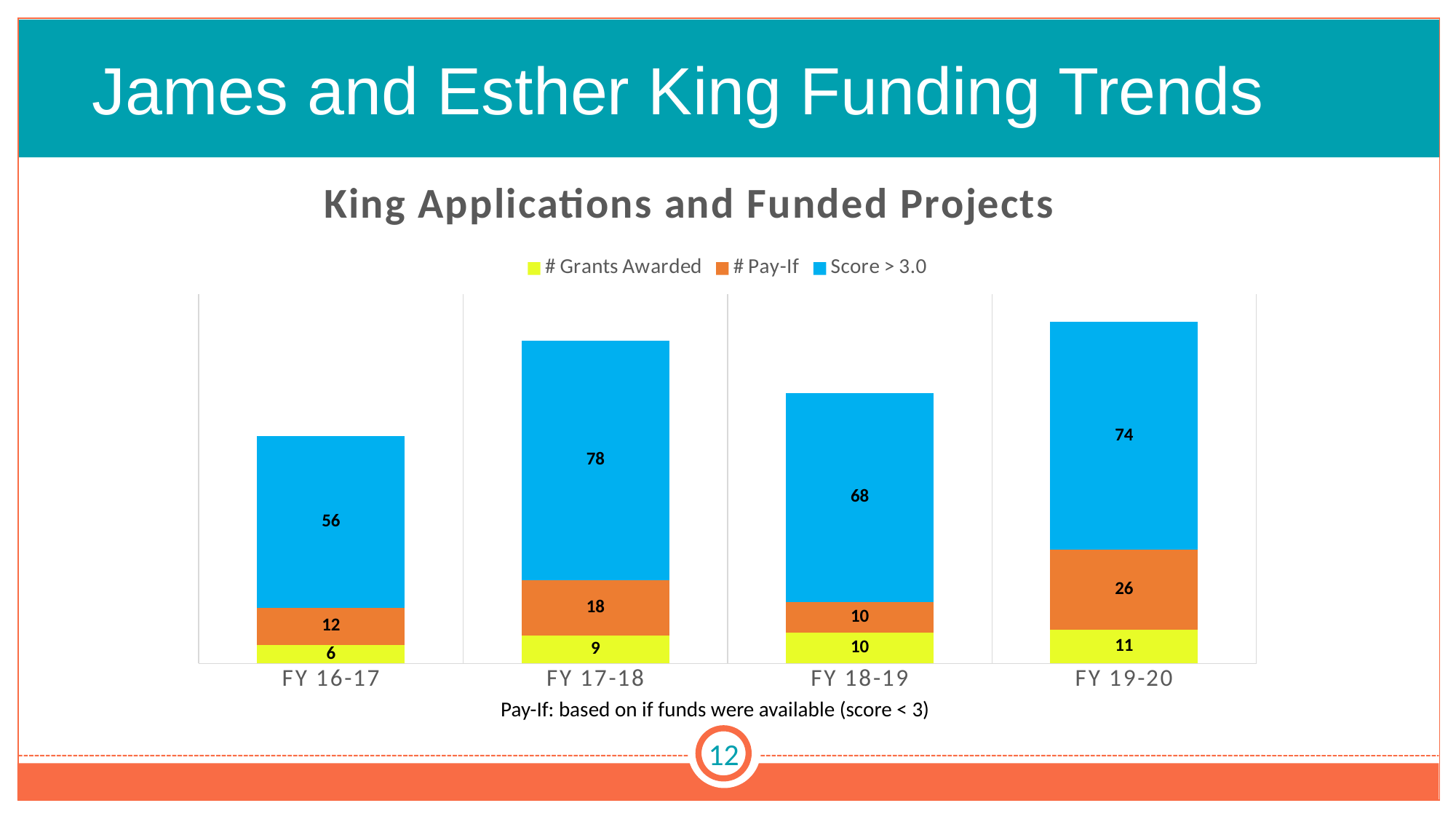
What is the total of the stacked bar for FY 18-19? 88 What is the value of # Grants Awarded for FY 16-17? 6 How many fiscal years are shown on the x axis? 4 How many series does the legend list? 3 Which is larger, # Grants Awarded for FY 17-18 or for FY 19-20? FY 19-20 Which fiscal year has the lowest # Pay-If value? FY 18-19 What is the total of the stacked bar for FY 19-20? 111 What is the difference between the Score > 3.0 values for FY 19-20 and FY 16-17? 18 What type of chart is shown? Stacked bar chart Which fiscal year has the highest Score > 3.0 value? FY 17-18 What is the value of # Pay-If for FY 19-20? 26 What is the value of Score > 3.0 for FY 17-18? 78